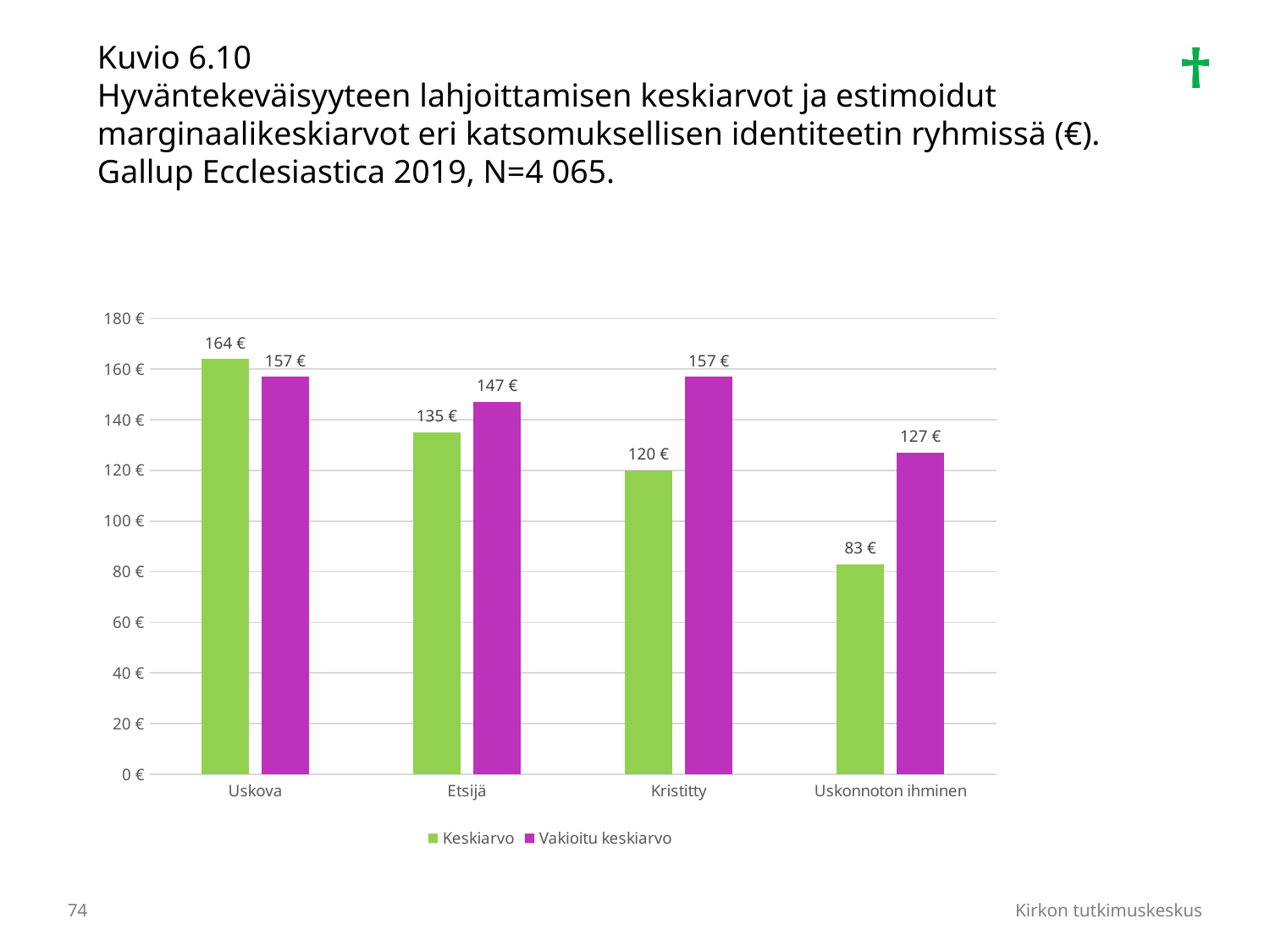
Which is larger for Kristitty: the Keskiarvo or the Vakioitu keskiarvo value? Vakioitu keskiarvo What is the Vakioitu keskiarvo value for Kristitty? 157 € What is the Vakioitu keskiarvo value for Etsijä? 147 € What is the Keskiarvo value for Uskova? 164 € What is the difference between the Vakioitu keskiarvo and Keskiarvo values for Uskonnoton ihminen? 44 € Which category has the highest Keskiarvo value? Uskova How many categories are shown on the x axis? 4 Which category has the lowest Vakioitu keskiarvo value? Uskonnoton ihminen What is the Keskiarvo value for Uskonnoton ihminen? 83 € What kind of chart is shown on the slide? Bar chart How many series does the legend list? 2 Which colour represents the Vakioitu keskiarvo series? Purple